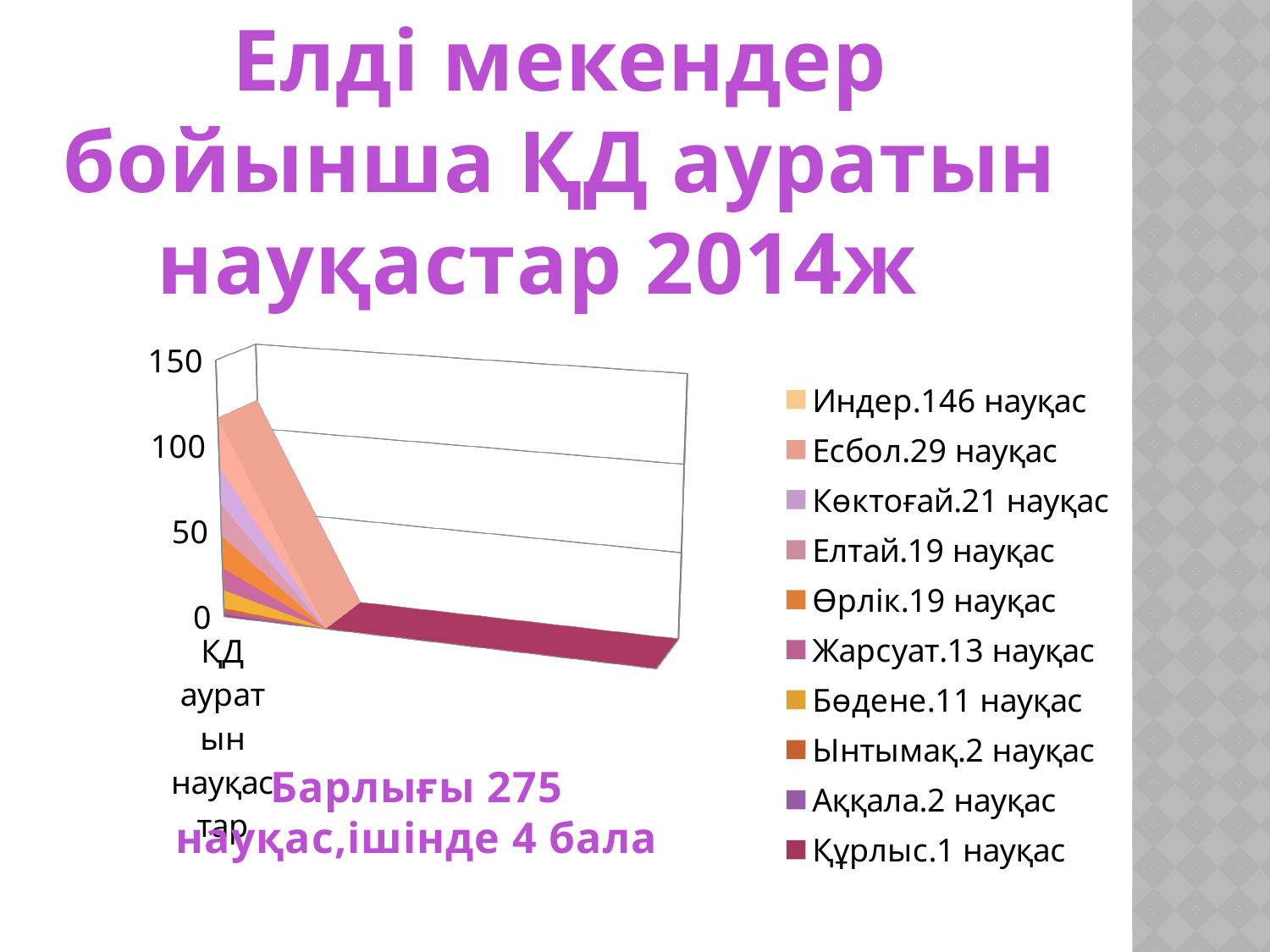
What is the highest value shown on the vertical axis? 150 According to the legend, how many patients are listed for Көктоғай? 21 According to the legend, how many patients are listed for Жарсуат? 13 What kind of chart is shown on the slide? 3D area chart What total number of patients is stated in the text below the chart? 275 According to the legend, how many patients are listed for Есбол? 29 How many series does the chart legend list? 10 What is the difference between the number of patients for Индер and Есбол? 117 Which settlement in the legend has the lowest number of patients? Құрлыс Which settlement in the legend has the highest number of patients? Индер Which has more patients, Көктоғай or Бөдене? Көктоғай According to the legend, how many patients (науқас) are listed for Индер? 146